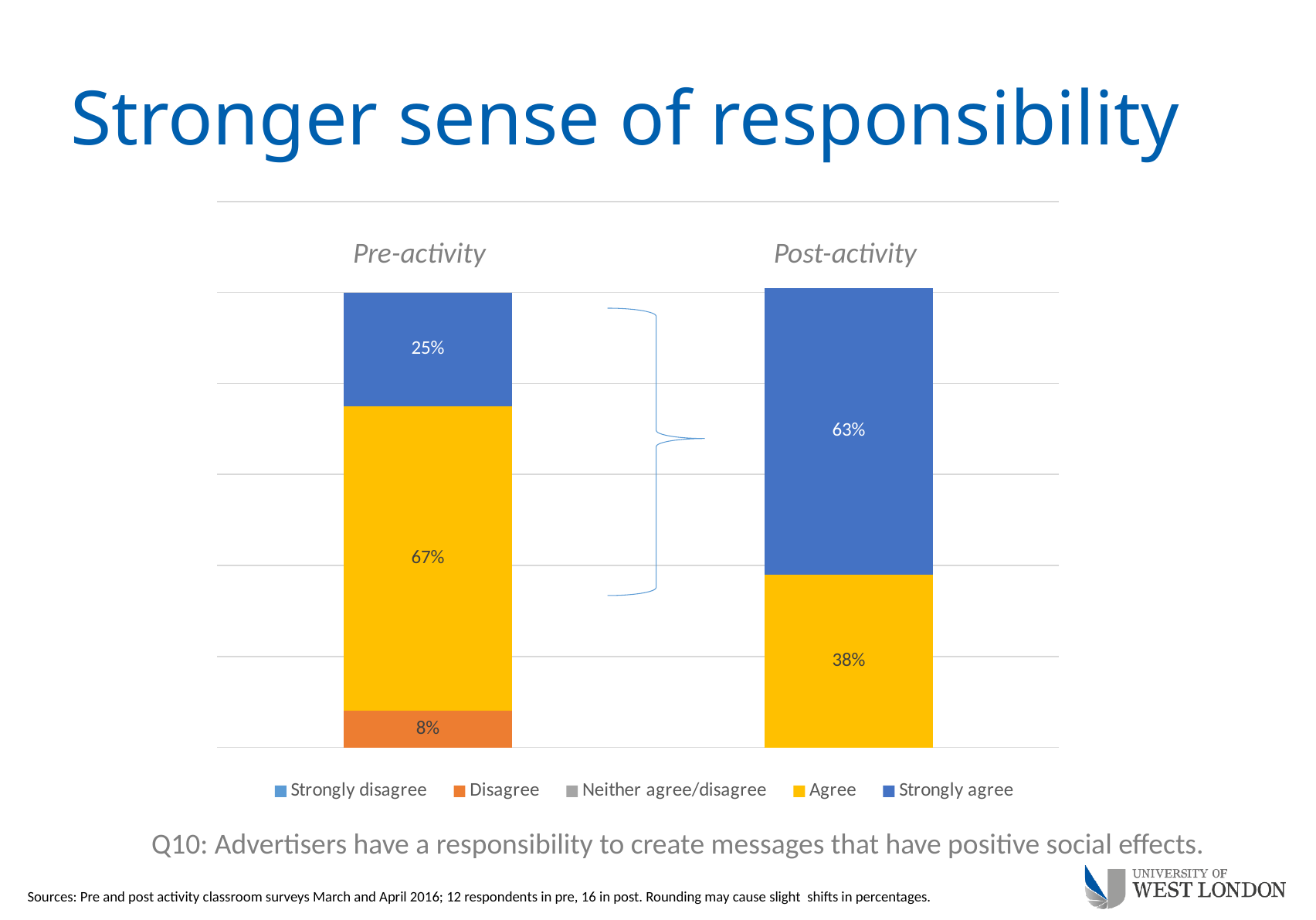
Which response category is the largest segment in the Post-activity bar? Strongly agree By how many percentage points did the Strongly agree share increase from Pre-activity to Post-activity? 38 Which response category is the smallest labelled segment in the Pre-activity bar? Disagree What kind of chart is shown on the slide? Stacked bar chart What percentage of Post-activity respondents answered Agree? 38% What percentage of Pre-activity respondents answered Strongly agree? 25% Which bar has the larger Agree share, Pre-activity or Post-activity? Pre-activity What percentage of Post-activity respondents answered Strongly agree? 63% What colour represents Agree in the chart? Yellow What percentage of Pre-activity respondents answered Agree? 67% How many series does the legend list? 5 What percentage of Pre-activity respondents answered Disagree? 8%